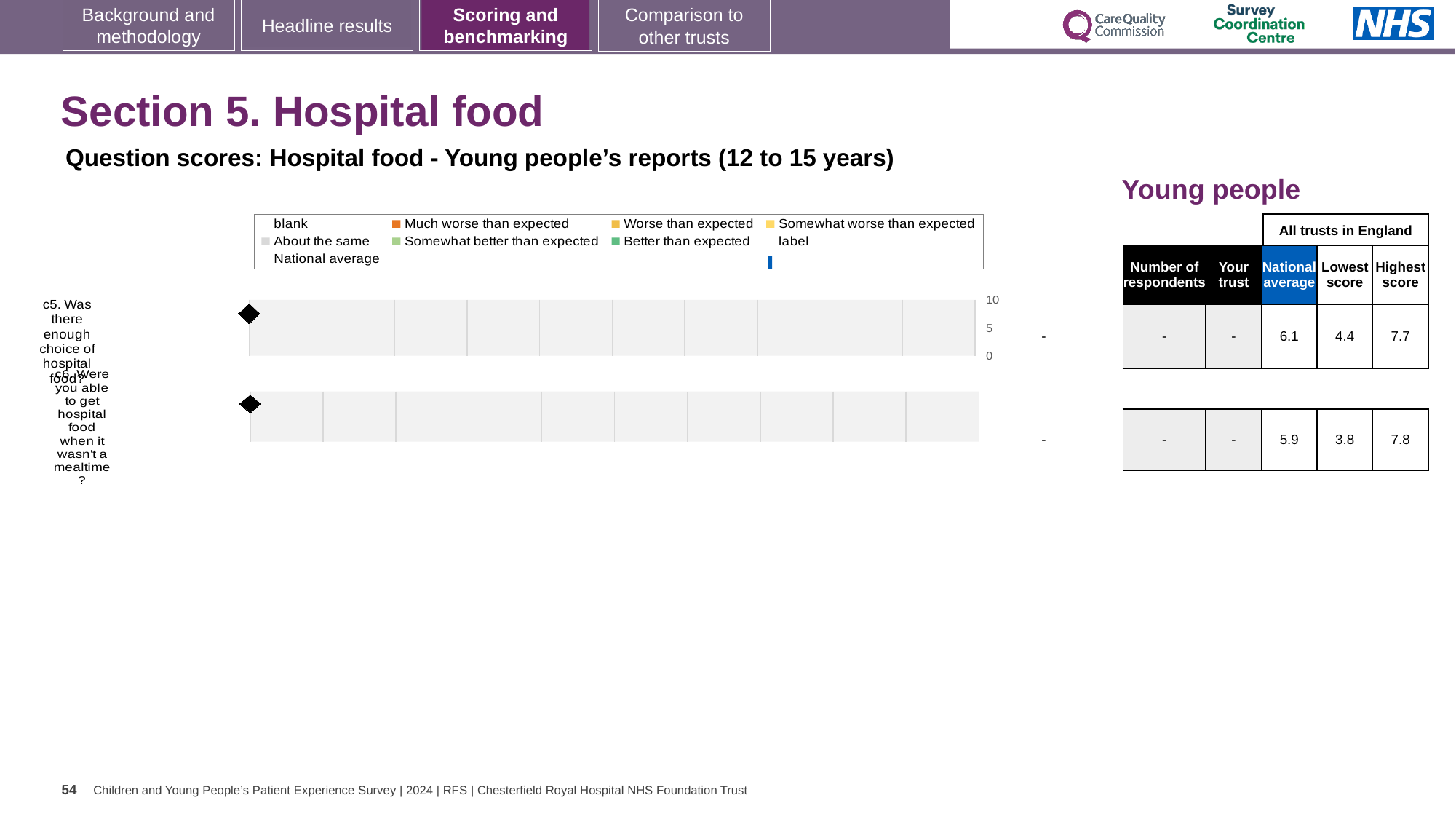
How many question categories are plotted on the chart? 2 What kind of chart is shown on the slide? bar chart According to the table, what is the lowest score across all trusts in England for c5? 4.4 Which question has the higher national average score, c5 or c6? c5 What is the difference between the highest and lowest scores for c6 in the table? 4.0 What is the label of the first (top) category on the chart? c5. Was there enough choice of hospital food? According to the table, what is the national average score for c6 (Were you able to get hospital food when it wasn't a mealtime?)? 5.9 What is the difference between the highest and lowest scores for c5 in the table? 3.3 According to the table, what is the highest score across all trusts in England for c6? 7.8 According to the table, what is the national average score for c5 (Was there enough choice of hospital food?)? 6.1 What is the highest value shown on the chart's axis? 10